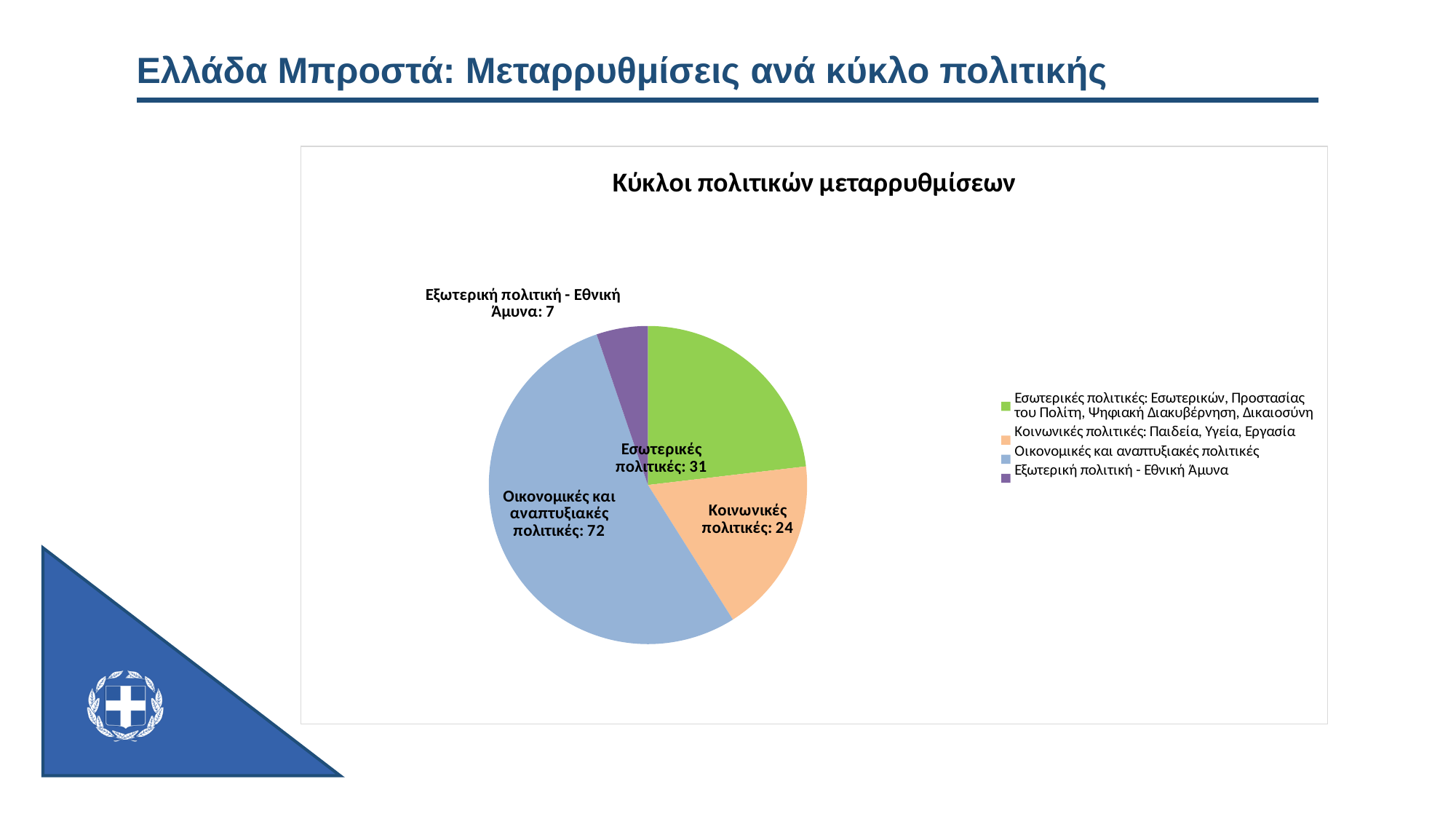
What is the value for Οικονομικές και αναπτυξιακές πολιτικές? 72 What is the value for Κοινωνικές πολιτικές? 24 What kind of chart is shown on the slide? Pie chart What is the value for Εσωτερικές πολιτικές? 31 Which category has the smallest slice? Εξωτερική πολιτική - Εθνική Άμυνα What is the difference between the values for Οικονομικές και αναπτυξιακές πολιτικές and Εσωτερικές πολιτικές? 41 Which category has the largest slice? Οικονομικές και αναπτυξιακές πολιτικές What is the value for Εξωτερική πολιτική - Εθνική Άμυνα? 7 What is the title of the chart? Κύκλοι πολιτικών μεταρρυθμίσεων Which is larger, the value for Εσωτερικές πολιτικές or the value for Κοινωνικές πολιτικές? Εσωτερικές πολιτικές How many entries does the legend list? 4 How many slices does the pie chart have? 4